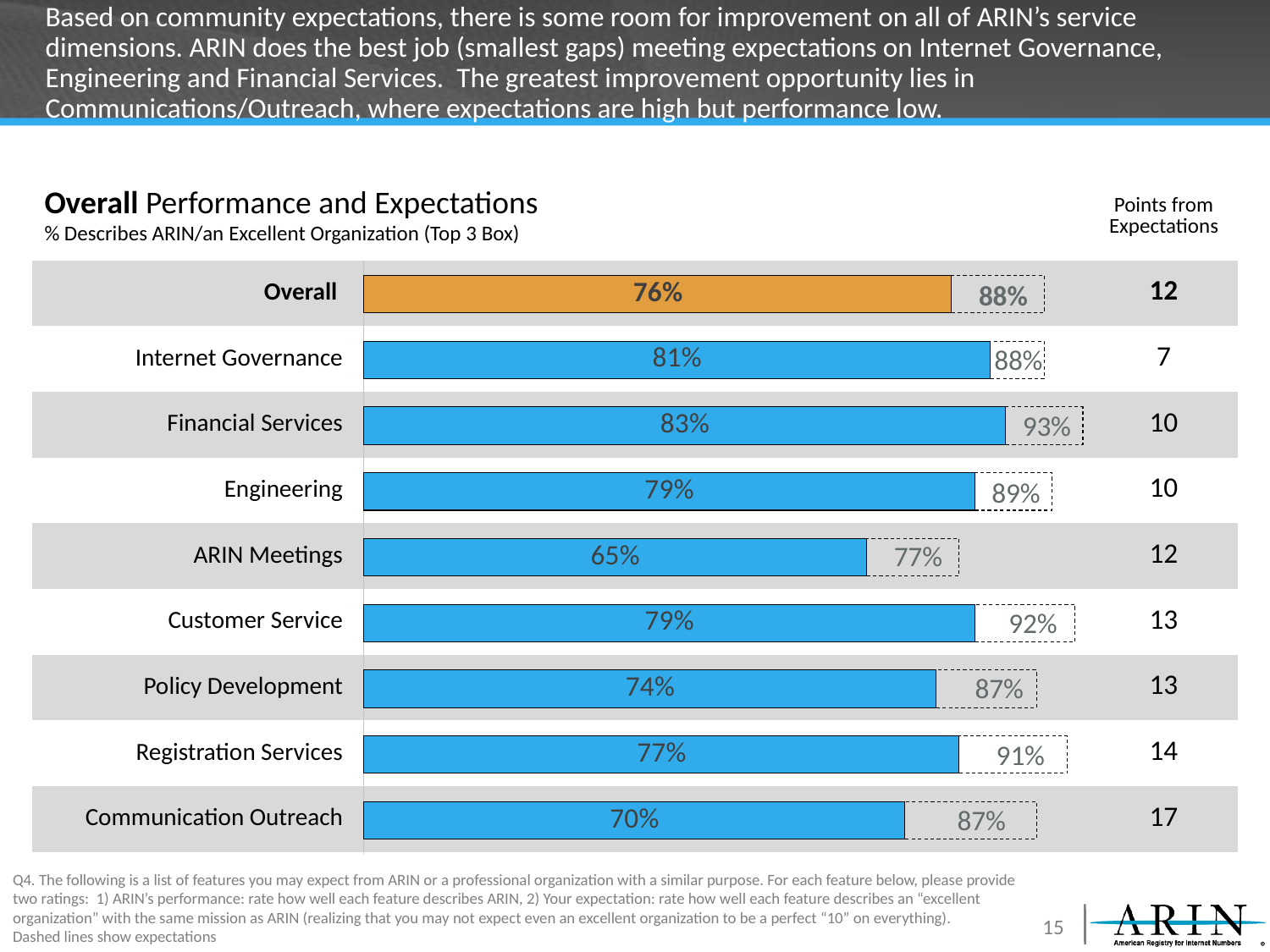
Which has a higher performance value, Internet Governance or Policy Development? Internet Governance What kind of chart is shown on the slide? Bar chart Which category has the highest performance value? Financial Services What is the performance value for Communication Outreach? 70% What is the expectation value (dashed bar) for Customer Service? 92% How many categories are shown in the chart? 9 What is the difference between the expectation and performance values for Financial Services? 10 Which category has the lowest performance value? ARIN Meetings Which category has the smallest number of points from expectations? Internet Governance Which category's performance bar is coloured orange rather than blue? Overall What is the performance value (solid bar) for Internet Governance? 81% Which category has the largest number of points from expectations? Communication Outreach